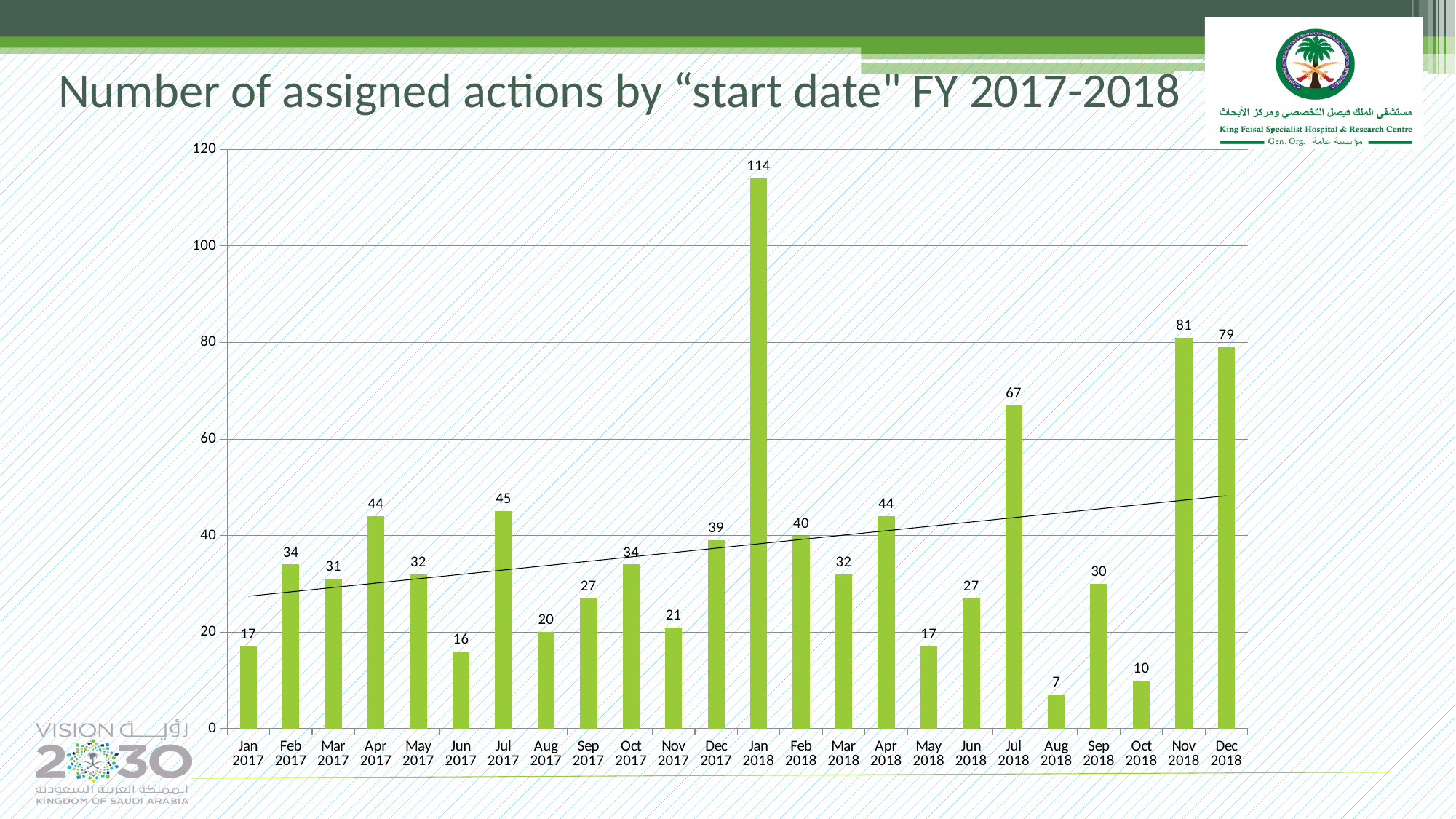
What is the number of assigned actions for Jan 2018? 114 Which is larger, the value for Apr 2017 or the value for Jul 2017? Jul 2017 What is the number of assigned actions for Nov 2018? 81 Is the value for Jul 2018 greater or less than 60? greater Which month has the highest number of assigned actions? Jan 2018 What is the difference between the values for Nov 2018 and Dec 2018? 2 What is the number of assigned actions for Aug 2018? 7 What kind of chart is shown on the slide? bar chart What is the title of the chart? Number of assigned actions by "start date" FY 2017-2018 How many months are shown on the x axis? 24 Which month has the lowest number of assigned actions? Aug 2018 What is the difference between the values for Jan 2018 and Jul 2018? 47